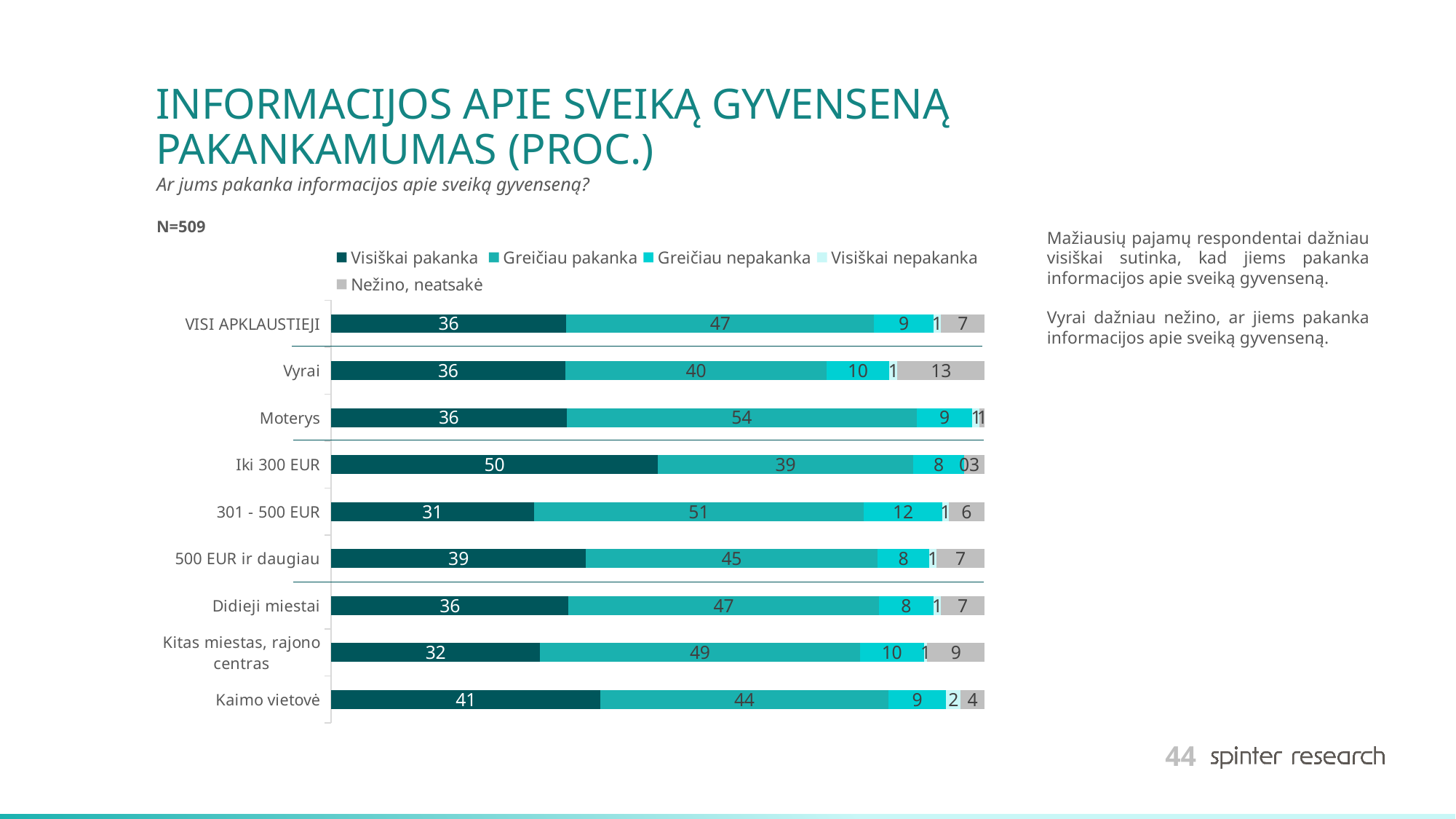
What is the "Visiškai pakanka" value for Iki 300 EUR? 50 Which category has the highest "Visiškai pakanka" value? Iki 300 EUR What is the "Nežino, neatsakė" value for Vyrai? 13 What is the total of the stacked bar for Vyrai? 100 Which has a larger "Greičiau nepakanka" value, 301 - 500 EUR or 500 EUR ir daugiau? 301 - 500 EUR What is the difference between the "Greičiau pakanka" values for Moterys and Vyrai? 14 How many series does the legend list? 5 What is the "Greičiau pakanka" value for Kitas miestas, rajono centras? 49 How many categories are shown on the chart? 9 What kind of chart is shown on the slide? Stacked bar chart What sample size (N) is stated on the slide? N=509 Which category has the lowest "Visiškai pakanka" value? 301 - 500 EUR